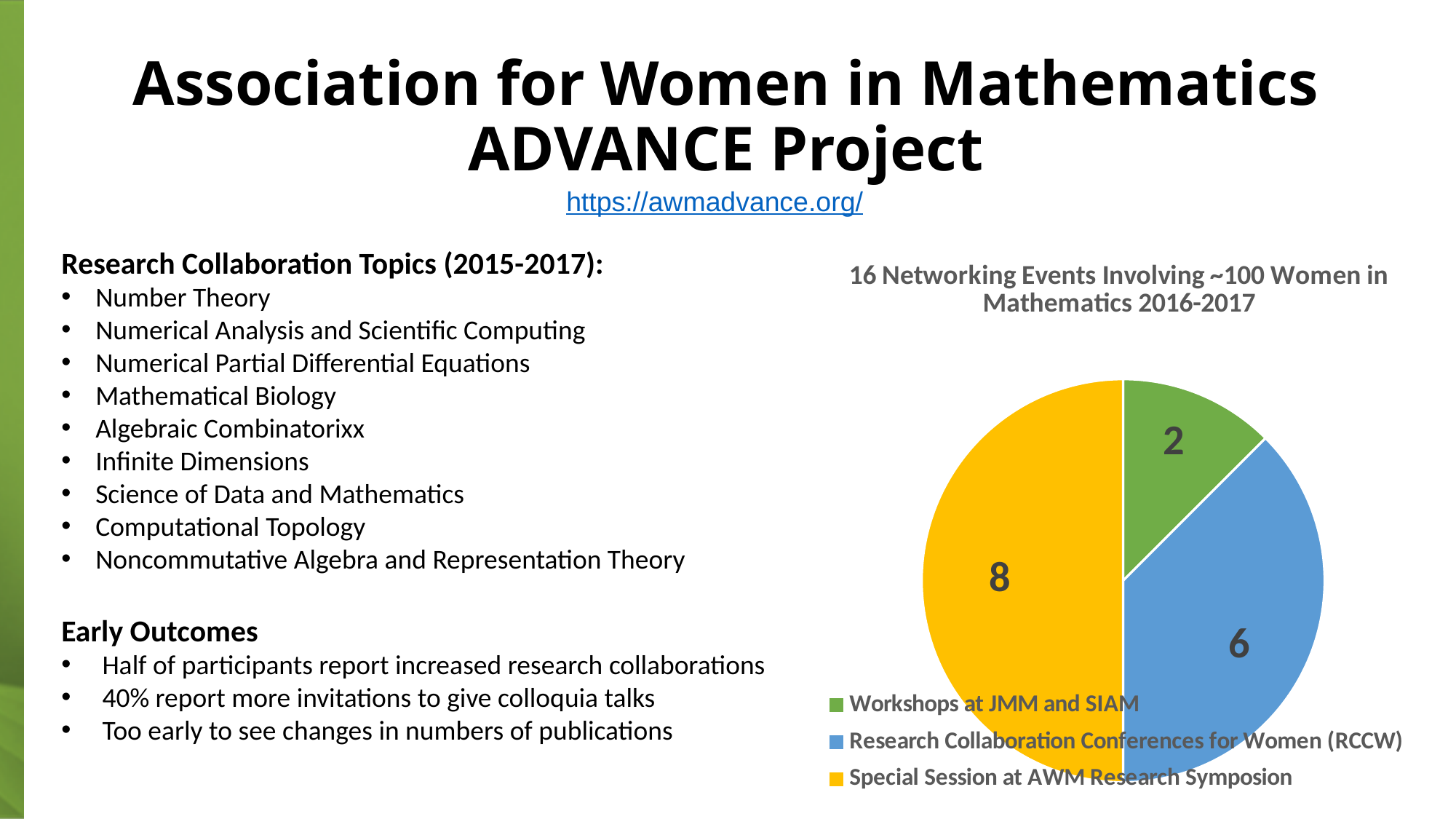
What type of chart is shown on the slide? Pie chart What is the value for Workshops at JMM and SIAM in the pie chart? 2 What is the value for Research Collaboration Conferences for Women (RCCW) in the pie chart? 6 What is the title of the pie chart? 16 Networking Events Involving ~100 Women in Mathematics 2016-2017 What share of the pie does the Special Session at AWM Research Symposion slice represent? 50% What is the difference between the values for Special Session at AWM Research Symposion and Workshops at JMM and SIAM? 6 How many slices does the pie chart have? 3 Which is larger: the value for Research Collaboration Conferences for Women (RCCW) or the value for Workshops at JMM and SIAM? Research Collaboration Conferences for Women (RCCW) How many entries does the pie chart's legend list? 3 Which category has the smallest slice in the pie chart? Workshops at JMM and SIAM What is the value for Special Session at AWM Research Symposion in the pie chart? 8 Which category has the largest slice in the pie chart? Special Session at AWM Research Symposion